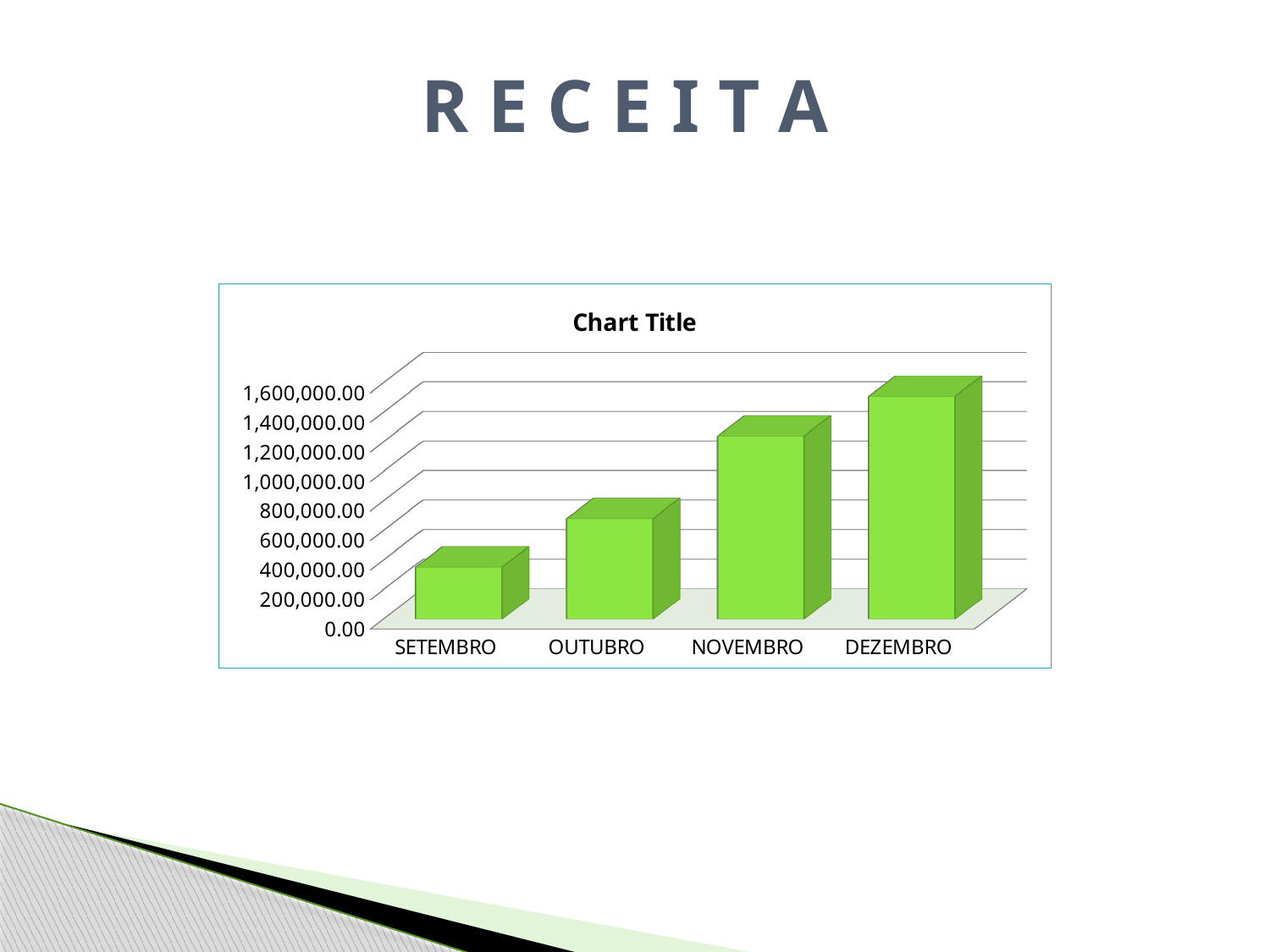
Which is larger, the value for SETEMBRO or the value for DEZEMBRO? DEZEMBRO Is the value for OUTUBRO greater or less than 1,000,000.00? less Is the value for DEZEMBRO greater or less than 1,200,000.00? greater What kind of chart is shown on the slide? bar chart Is the value for SETEMBRO greater or less than 600,000.00? less Which month has the highest value in the chart? DEZEMBRO Do the values rise or fall from SETEMBRO to DEZEMBRO? rise How many categories are shown on the x axis of the chart? 4 Which is larger, the value for NOVEMBRO or the value for OUTUBRO? NOVEMBRO Which month has the lowest value in the chart? SETEMBRO What is the title printed above the chart? Chart Title